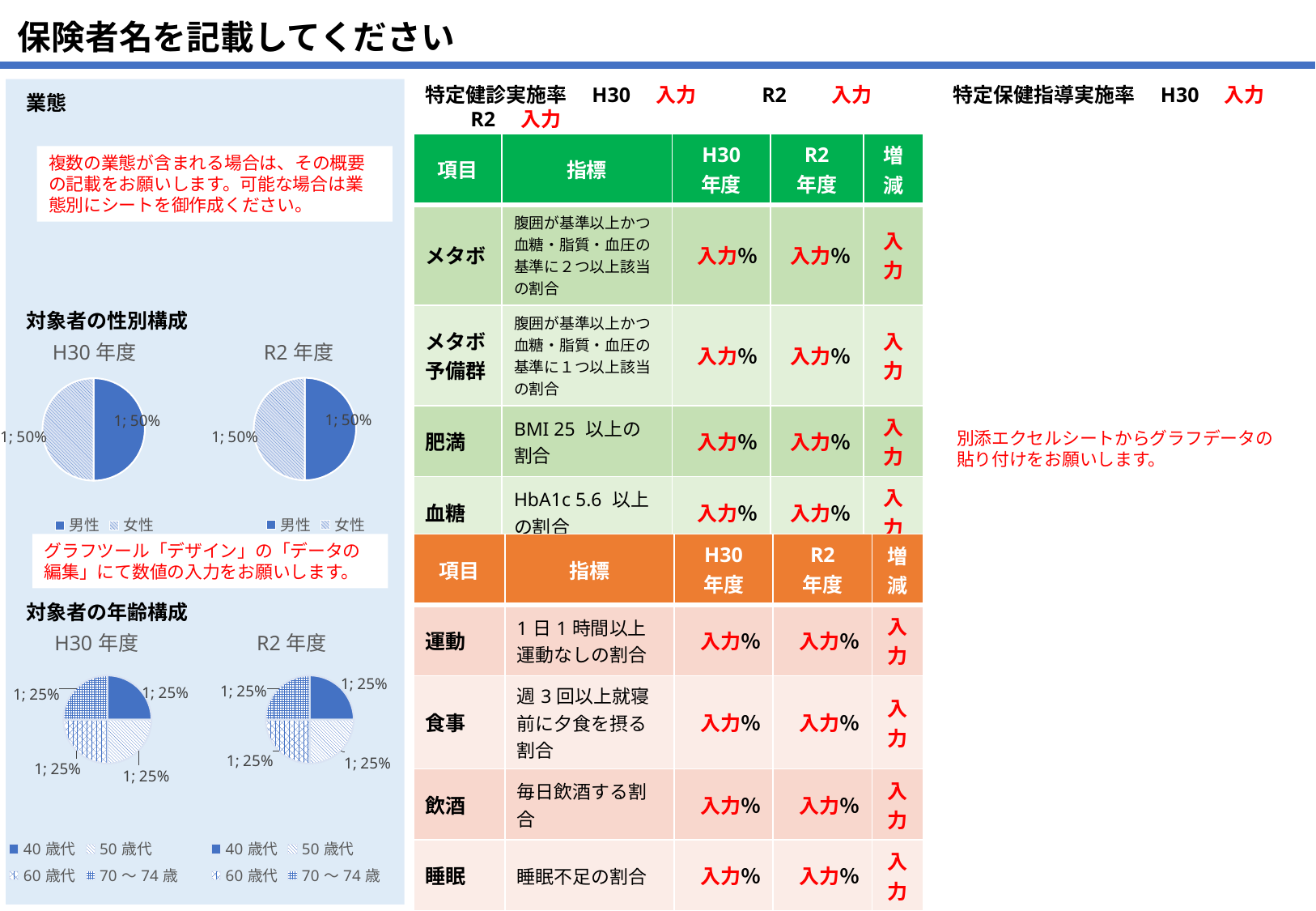
What kind of chart is the H30 年度 chart under 対象者の性別構成? pie chart How many entries does the legend of the R2 年度 pie chart under 対象者の性別構成 list? 2 What is the data label shown on the 男性 slice of the R2 年度 pie chart under 対象者の性別構成? 1; 50% How many slices does the H30 年度 pie chart under 対象者の年齢構成 have? 4 In the H30 年度 pie chart under 対象者の性別構成, what share does 男性 have? 50% How many entries does the legend of the R2 年度 pie chart under 対象者の年齢構成 list? 4 In the R2 年度 pie chart under 対象者の性別構成, what share does 女性 have? 50% In the H30 年度 pie chart under 対象者の性別構成, is the 男性 share larger than the 女性 share, or are they equal? equal In the R2 年度 pie chart under 対象者の年齢構成, what share does 40 歳代 have? 25% How many slices does the H30 年度 pie chart under 対象者の性別構成 have? 2 What are the legend entries of the H30 年度 pie chart under 対象者の年齢構成? 40 歳代, 50 歳代, 60 歳代, 70～74 歳